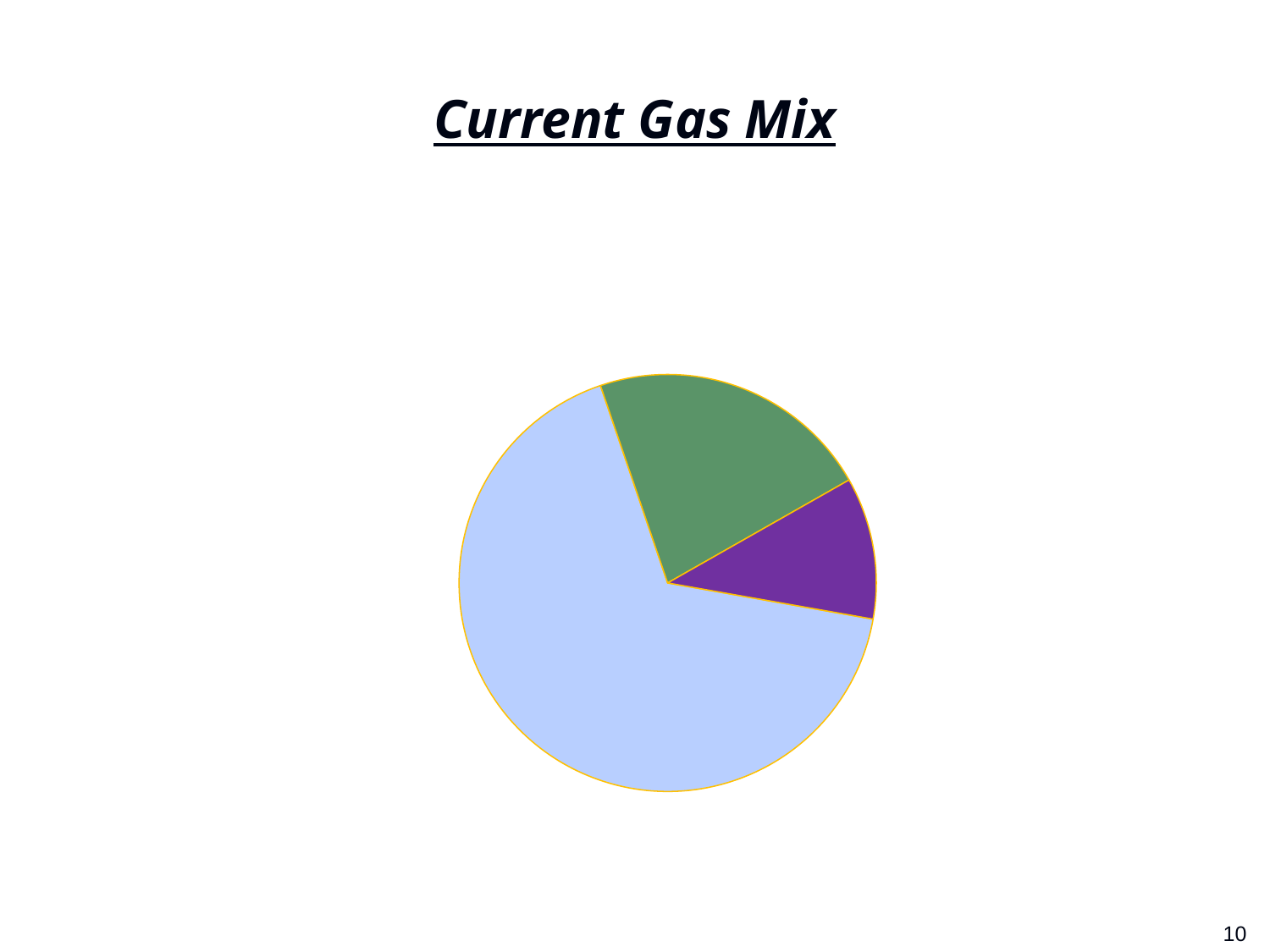
Does the pie chart include a legend? No How many slices does the pie chart have? 3 Which slice is larger, the green slice or the purple slice? Green What is the title of the chart on the slide? Current Gas Mix Which colour slice is the largest in the pie chart? Light blue Which colour slice is the smallest in the pie chart? Purple What kind of chart is shown on the slide? Pie chart Does the light blue slice take up more or less than half of the pie? More Which slice is larger, the light blue slice or the green slice? Light blue